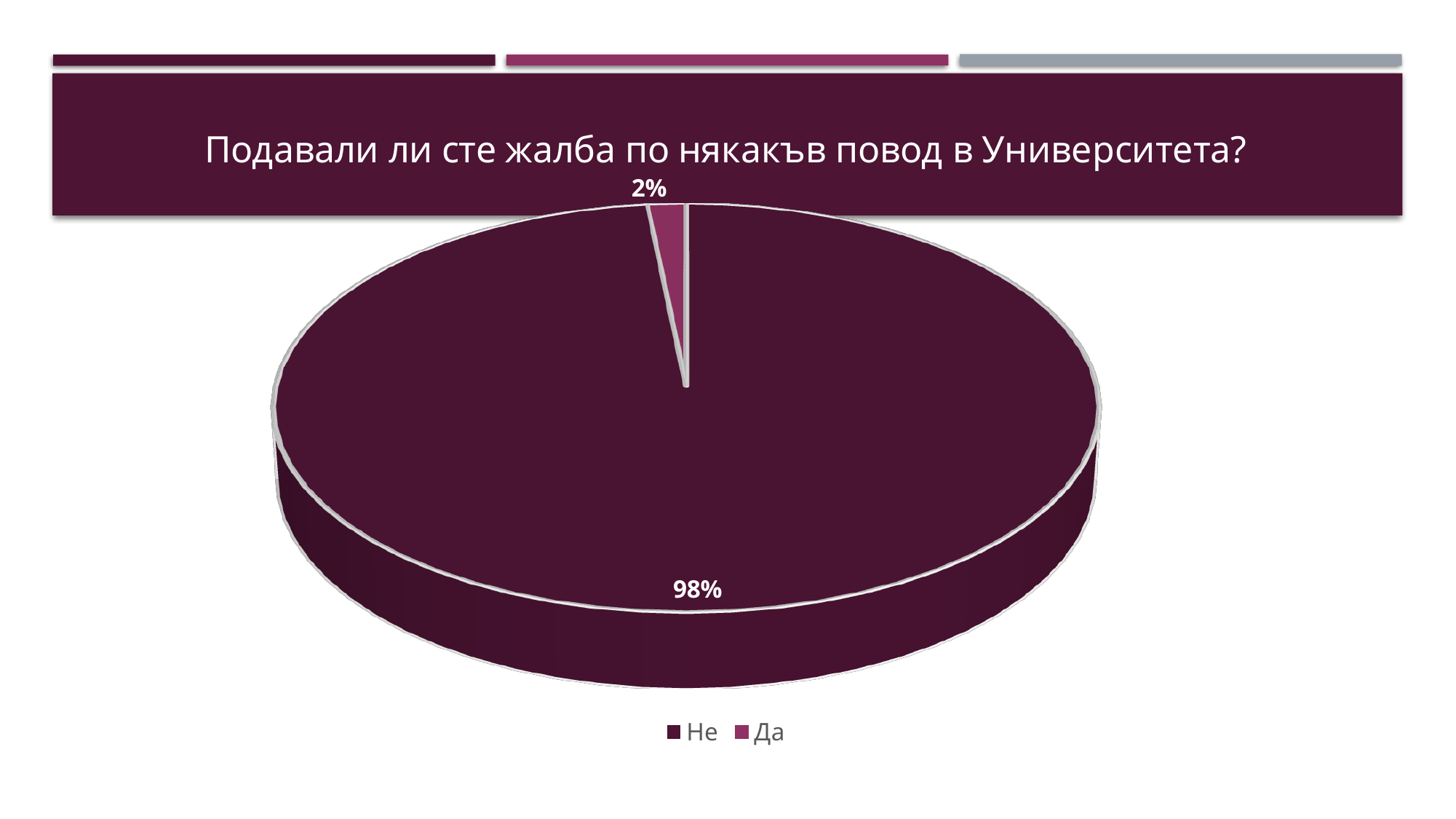
What is the difference in percentage points between the "Не" and "Да" slices? 96 What is the total of the two percentages shown on the pie? 100% Which category has the largest share of the pie? Не How many slices does the pie chart have? 2 Which category has the smallest share of the pie? Да Which slice is larger, "Не" or "Да"? Не How many entries does the legend list? 2 What is the title of the chart? Подавали ли сте жалба по някакъв повод в Университета? What percentage of the pie is labelled "Да"? 2% What kind of chart is shown on the slide? Pie chart What percentage of the pie is labelled "Не"? 98% Which legend entry is shown in the lighter magenta colour? Да